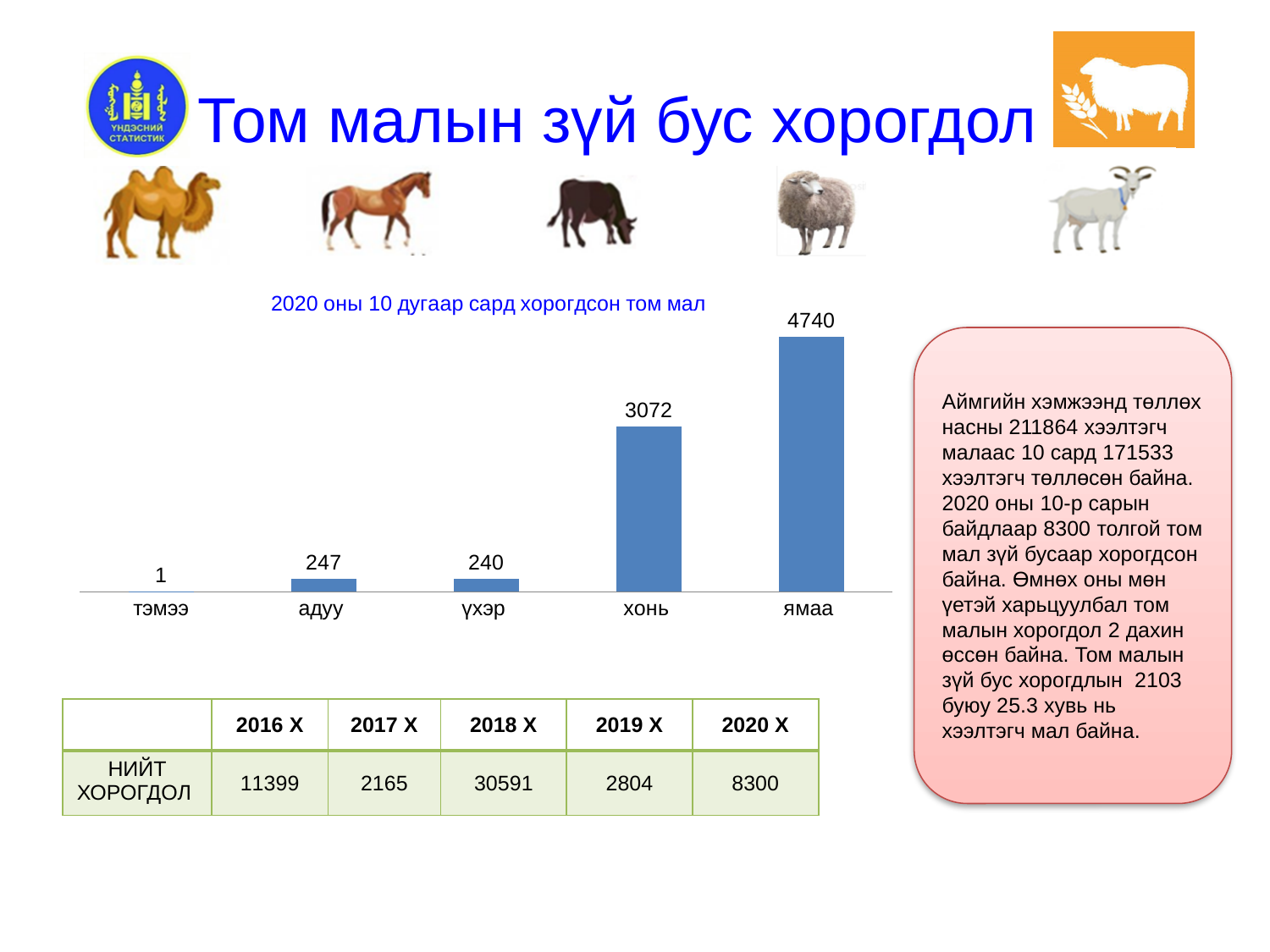
Which category has the lowest value in the chart? тэмээ Which is larger, the value for хонь or the value for үхэр? хонь What is the value for ямаа in the chart? 4740 What is the value for хонь in the chart? 3072 What is the value for тэмээ in the chart? 1 What is the title of the chart? 2020 оны 10 дугаар сард хорогдсон том мал What is the difference between the values for ямаа and хонь? 1668 Which category has the highest value in the chart? ямаа How many categories are shown in the chart? 5 What is the difference between the values for адуу and үхэр? 7 What kind of chart is shown on the slide? bar chart What is the value for адуу in the chart? 247